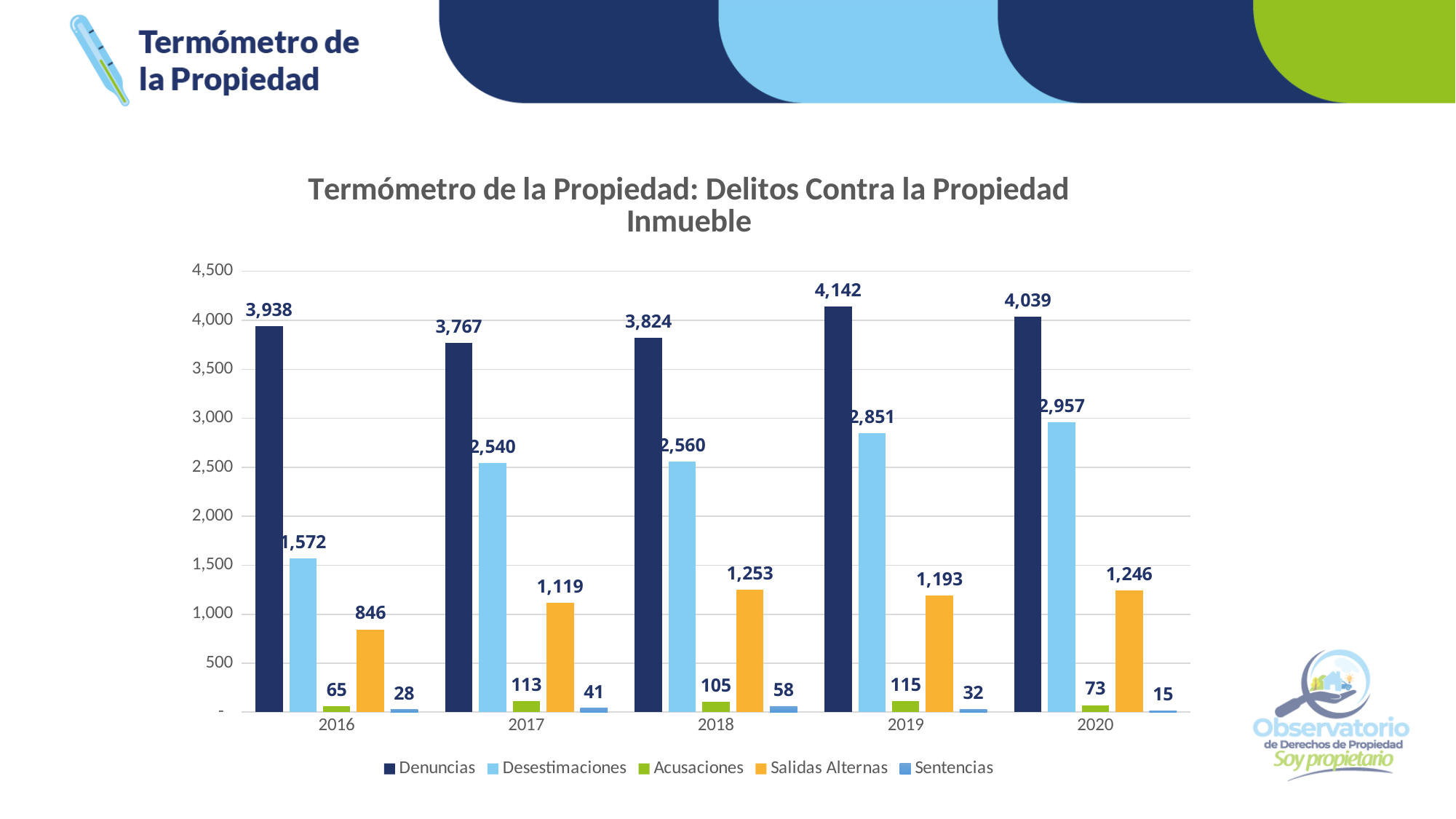
What is the value of Desestimaciones in 2016? 1,572 What is the value of Denuncias in 2019? 4,142 How many years are shown on the x axis? 5 What kind of chart is shown on the slide? Bar chart How many series does the legend list? 5 Does Desestimaciones rise or fall from 2016 to 2020? Rise In which year is Acusaciones lowest? 2016 Which is larger, Salidas Alternas in 2017 or Salidas Alternas in 2019? Salidas Alternas in 2019 What is the value of Sentencias in 2020? 15 What is the value of Salidas Alternas in 2018? 1,253 What is the difference between Denuncias and Desestimaciones in 2020? 1,082 In which year is Denuncias highest? 2019